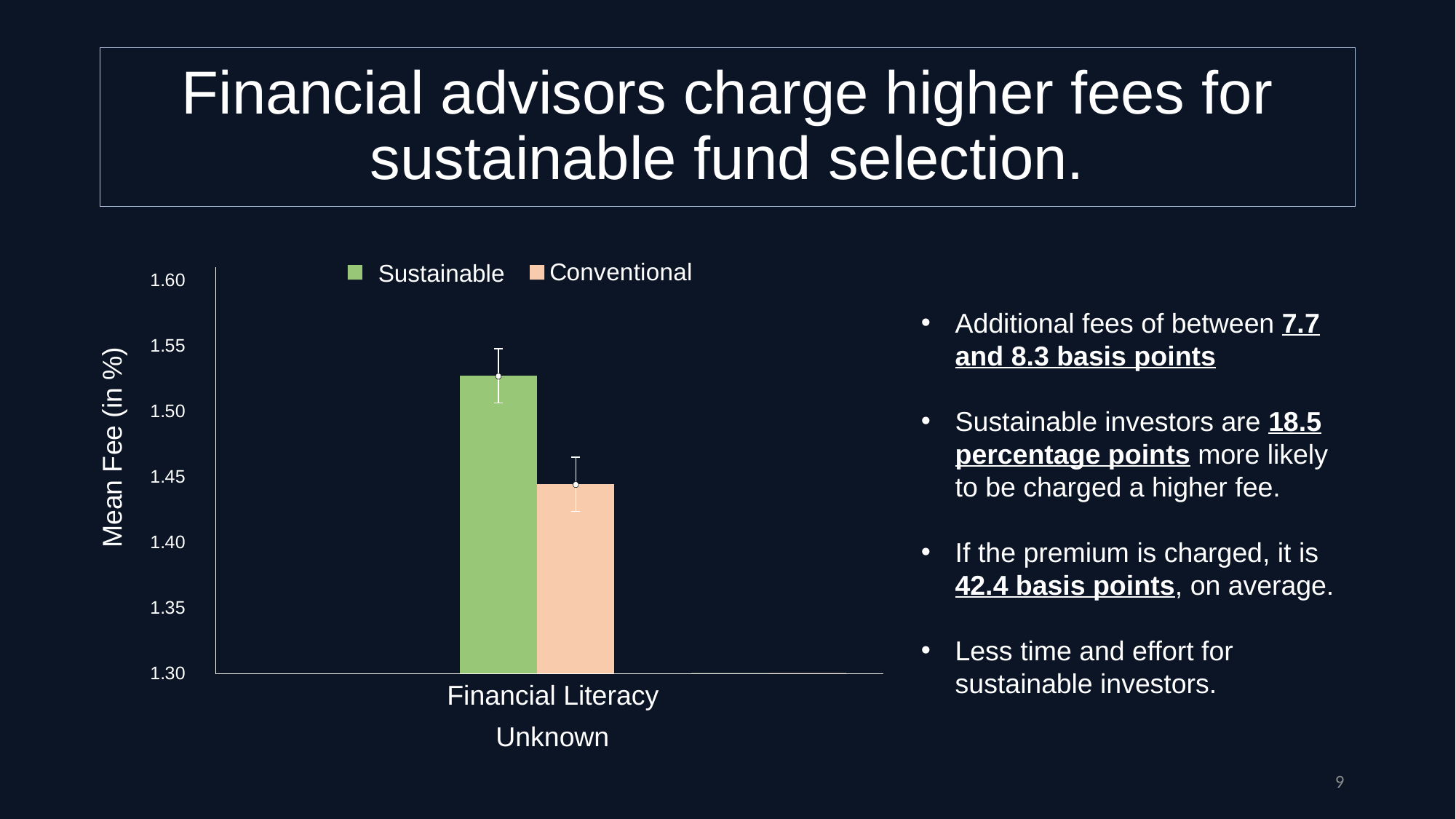
Is the mean fee for the Conventional series greater or less than 1.40? greater What is the label of the y axis of the chart? Mean Fee (in %) Which series has the lowest bar in the chart? Conventional What kind of chart is shown on the slide? bar chart Is the mean fee for the Sustainable series greater or less than 1.55? less Is the mean fee for the Conventional series greater or less than 1.50? less Which series has the higher mean fee for Financial Literacy Unknown, Sustainable or Conventional? Sustainable What is the category label shown on the x axis of the chart? Financial Literacy Unknown How many categories are plotted on the x axis of the chart? 1 How many series does the chart legend list? 2